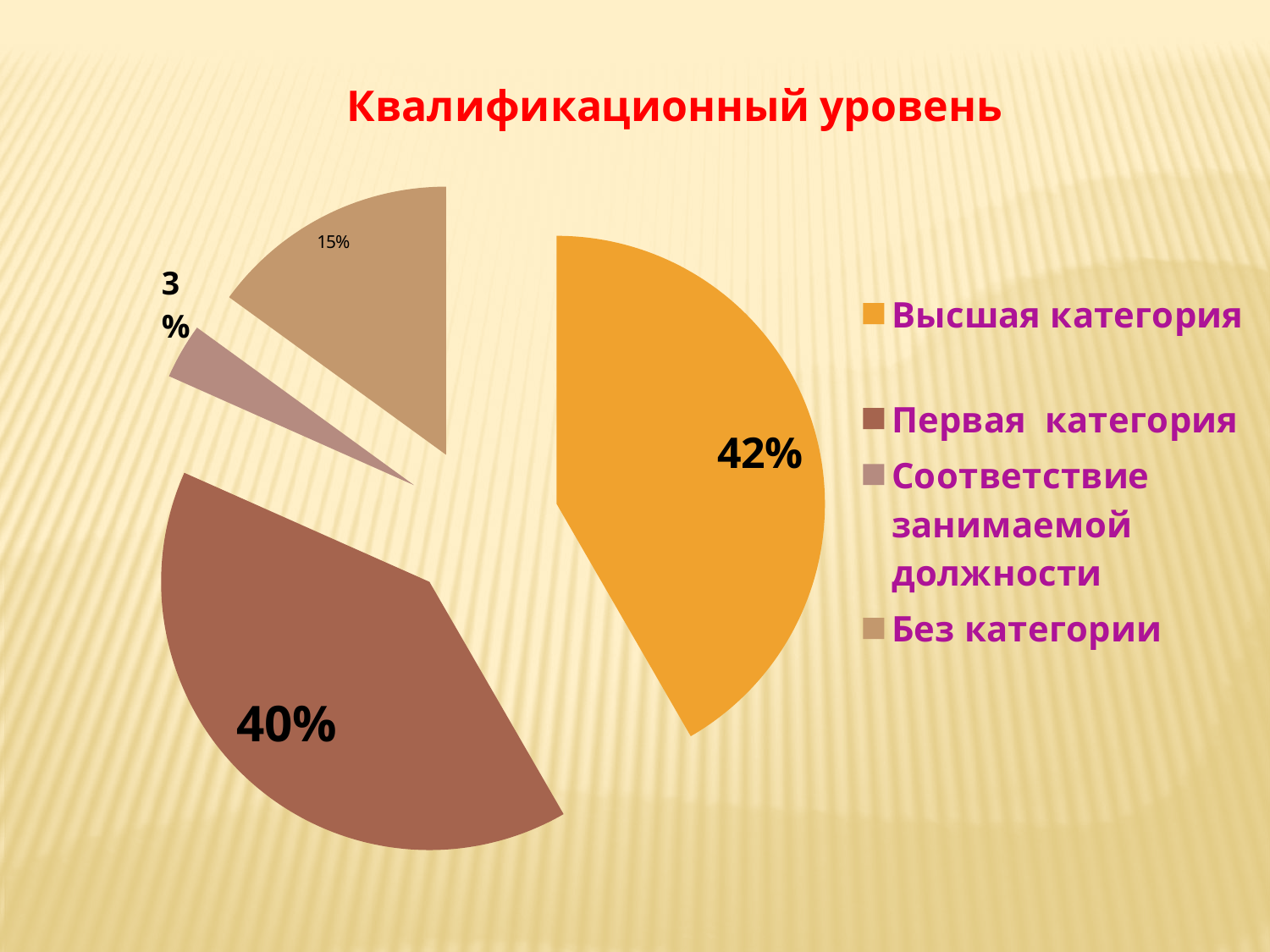
Which category has the largest share of the pie? Высшая категория How many categories does the legend list? 4 What share of the pie does Без категории have? 15% What is the title of the chart? Квалификационный уровень What is the difference between the shares of Без категории and Соответствие занимаемой должности? 12% What share of the pie does Соответствие занимаемой должности have? 3% What is the difference between the shares of Высшая категория and Первая категория? 2% Which is larger: the share of Без категории or the share of Соответствие занимаемой должности? Без категории What share of the pie does Высшая категория have? 42% Which category has the smallest share of the pie? Соответствие занимаемой должности What type of chart is shown on the slide? Pie chart What share of the pie does Первая категория have? 40%